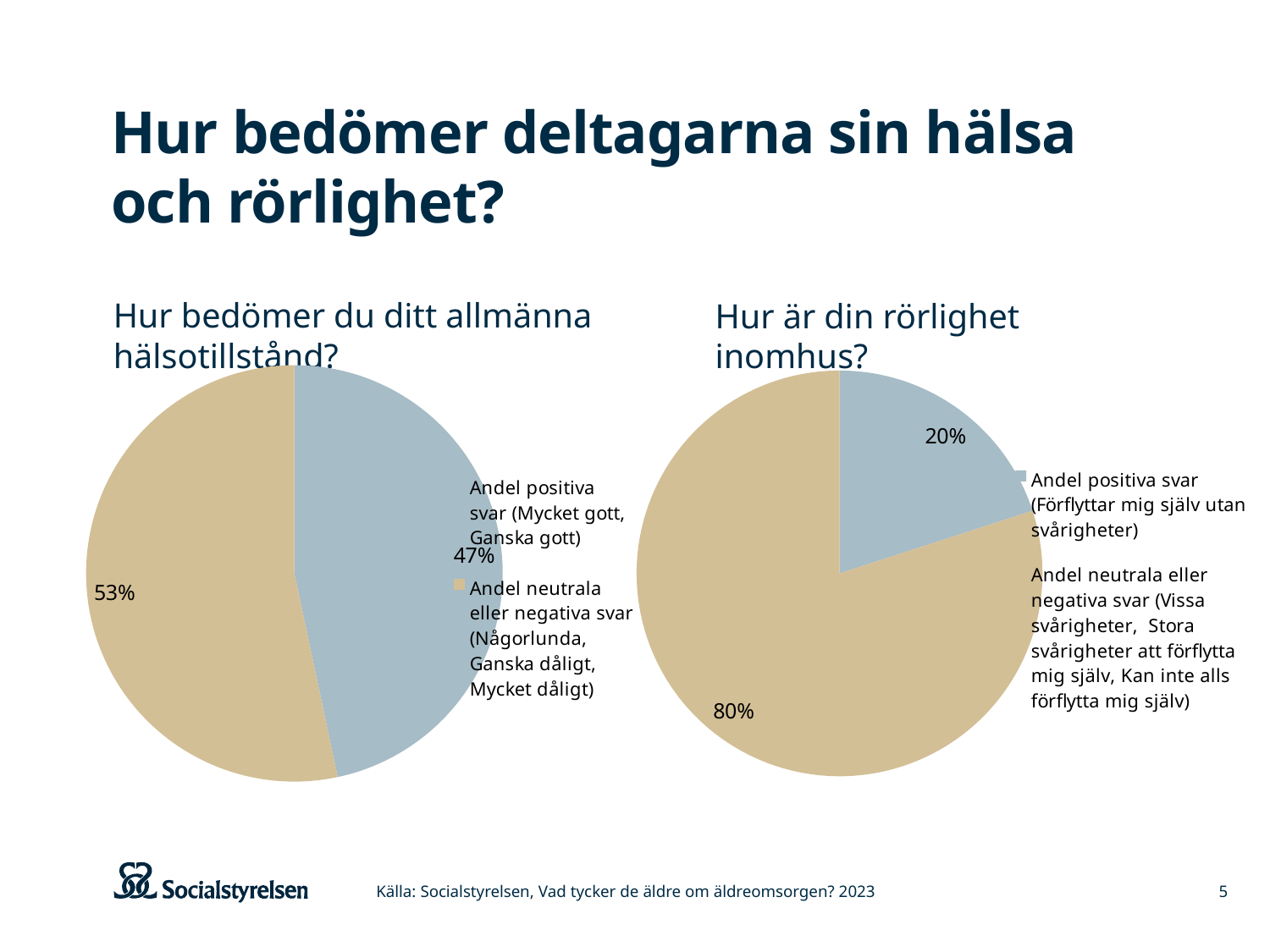
In the chart titled "Hur bedömer du ditt allmänna hälsotillstånd?", what colour is the slice for Andel positiva svar? Blue-grey In the chart titled "Hur bedömer du ditt allmänna hälsotillstånd?", what share of responses are neutral or negative (Andel neutrala eller negativa svar)? 53% Which chart shows a larger share of positive responses: "Hur bedömer du ditt allmänna hälsotillstånd?" or "Hur är din rörlighet inomhus?"? Hur bedömer du ditt allmänna hälsotillstånd? In the chart titled "Hur bedömer du ditt allmänna hälsotillstånd?", what share of responses are positive (Andel positiva svar)? 47% In the chart titled "Hur bedömer du ditt allmänna hälsotillstånd?", which category has the smallest slice? Andel positiva svar How many slices does the pie chart titled "Hur är din rörlighet inomhus?" have? 2 In the chart titled "Hur bedömer du ditt allmänna hälsotillstånd?", what is the difference in percentage points between the neutral/negative share and the positive share? 6 percentage points In the chart titled "Hur är din rörlighet inomhus?", what is the difference in percentage points between the neutral/negative share and the positive share? 60 percentage points In the chart titled "Hur är din rörlighet inomhus?", what share of responses are positive (Andel positiva svar)? 20% In the chart titled "Hur är din rörlighet inomhus?", which category has the largest slice? Andel neutrala eller negativa svar In the chart titled "Hur är din rörlighet inomhus?", what share of responses are neutral or negative (Andel neutrala eller negativa svar)? 80% What kind of chart is used on the left side of the slide, under "Hur bedömer du ditt allmänna hälsotillstånd?"? Pie chart